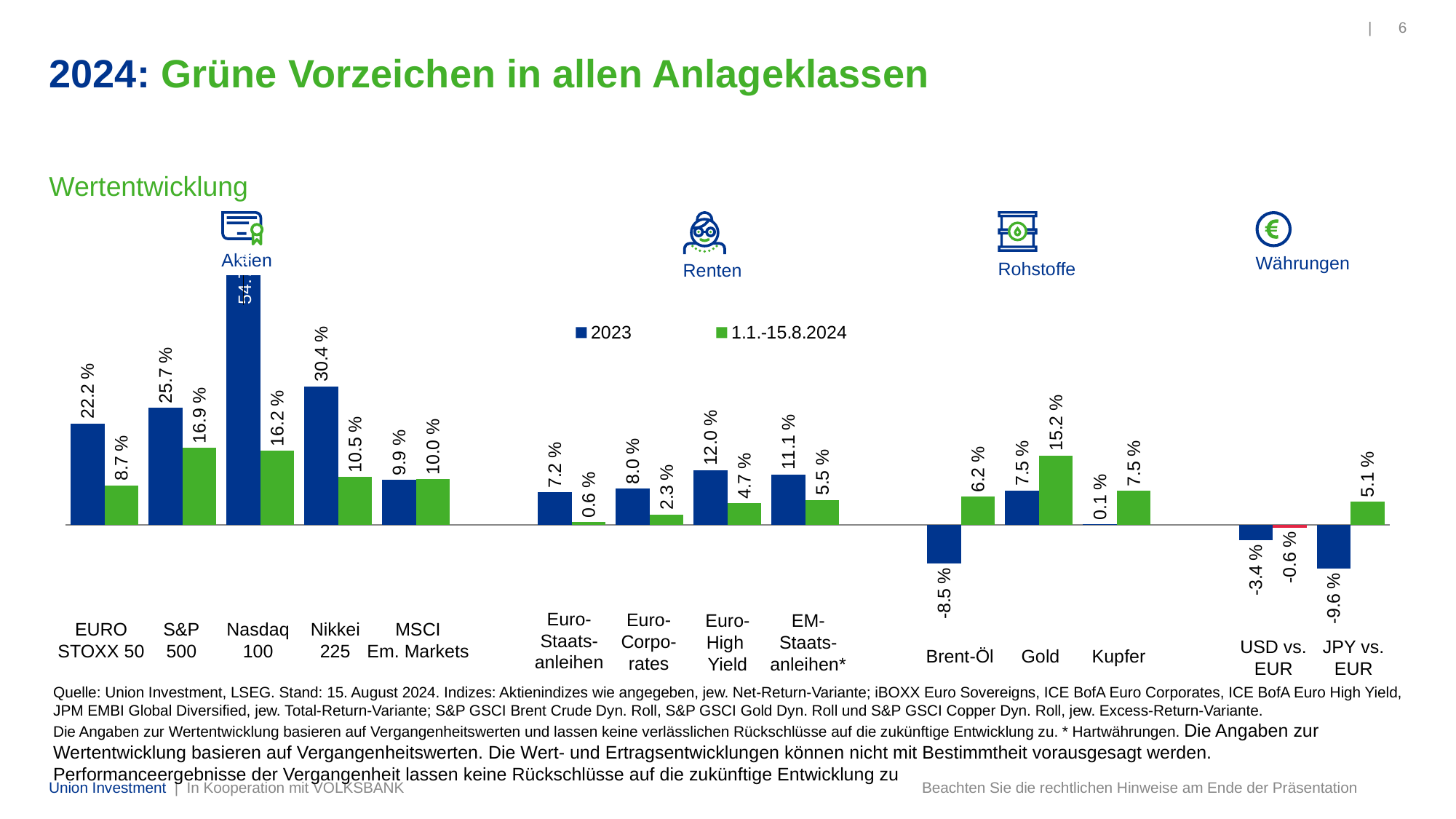
What type of chart is shown on the slide? Bar chart How many categories are shown on the x axis? 14 What was the 1.1.-15.8.2024 value for Gold? 15.2 % What was the 2023 value for the S&P 500? 25.7 % What was the 2023 value for Brent-Öl? -8.5 % Which category has the highest 2023 value? Nasdaq 100 What is the difference between the 2023 and 1.1.-15.8.2024 values for the S&P 500? 8.8 percentage points Which is larger for Kupfer: the 2023 value or the 1.1.-15.8.2024 value? 1.1.-15.8.2024 What was the 1.1.-15.8.2024 value for Euro-Staatsanleihen? 0.6 % Which category has the highest 1.1.-15.8.2024 value? S&P 500 How many series does the legend list? 2 Which category has the lowest 2023 value? JPY vs. EUR